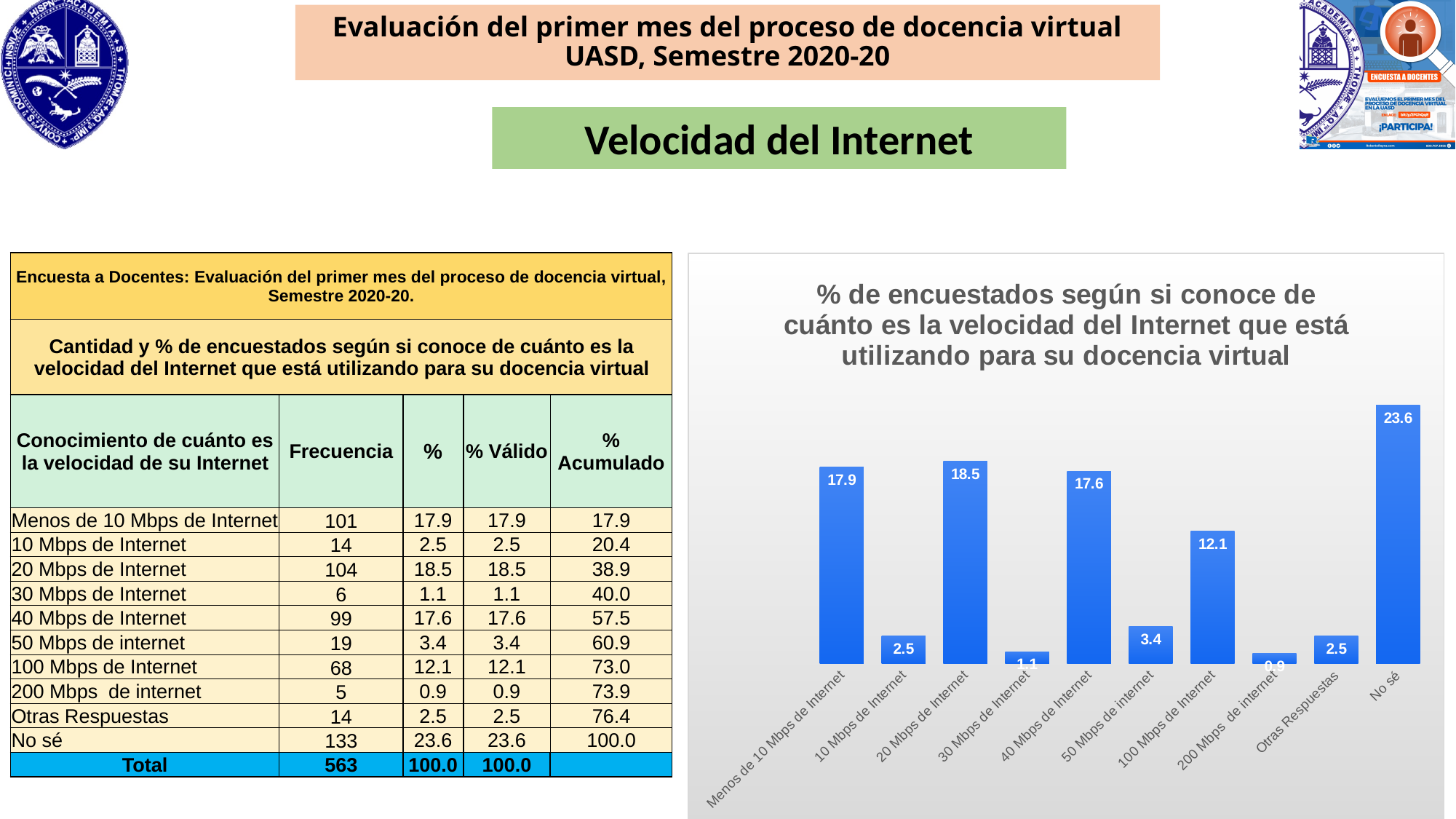
What is the difference between the values for "Menos de 10 Mbps de Internet" and "40 Mbps de Internet"? 0.3 What kind of chart is shown on the slide? Bar chart What is the difference between the values for "No sé" and "20 Mbps de Internet"? 5.1 Which is larger, the value for "50 Mbps de internet" or the value for "10 Mbps de Internet"? 50 Mbps de internet What is the value shown for "200 Mbps de internet" in the chart? 0.9 What is the value shown for "20 Mbps de Internet" in the chart? 18.5 How many categories are plotted in the chart? 10 Which category has the highest value in the chart? No sé What is the title of the chart? % de encuestados según si conoce de cuánto es la velocidad del Internet que está utilizando para su docencia virtual What is the value shown for "100 Mbps de Internet" in the chart? 12.1 What is the value shown for "No sé" in the chart? 23.6 Which category has the lowest value in the chart? 200 Mbps de internet